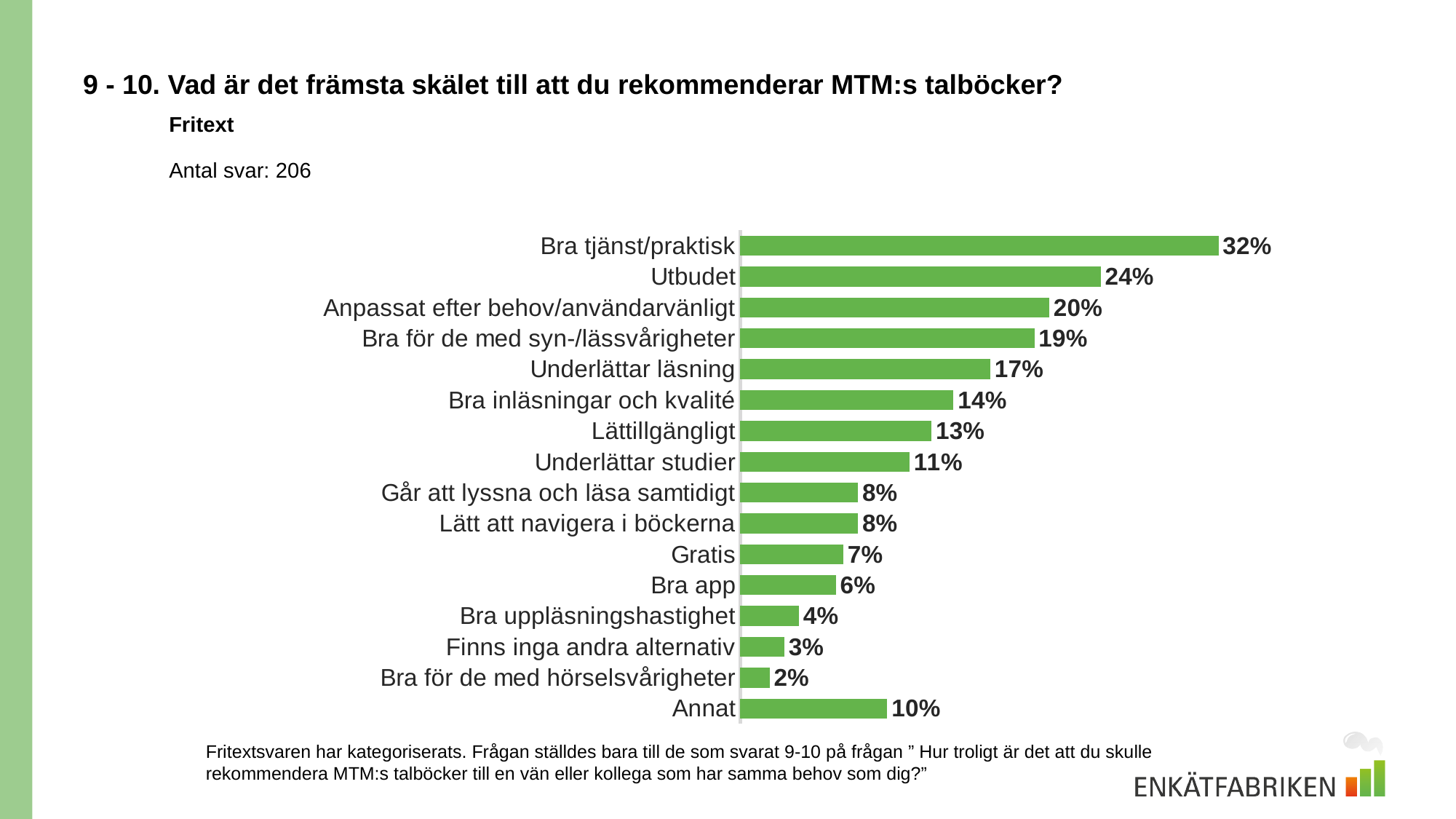
Which is larger, the value for "Lättillgängligt" or the value for "Underlättar studier"? Lättillgängligt What is the number of responses (Antal svar) stated on the slide? 206 What is the value for "Bra tjänst/praktisk"? 32% Which category has the lowest value? Bra för de med hörselsvårigheter How many categories are shown in the chart? 16 What is the difference between the values for "Bra tjänst/praktisk" and "Annat"? 22% What colour are the bars in the chart? Green What is the difference between the values for "Utbudet" and "Anpassat efter behov/användarvänligt"? 4% Which category has the highest value? Bra tjänst/praktisk What kind of chart is shown on the slide? Bar chart What is the value for "Underlättar läsning"? 17% What is the value for "Annat"? 10%